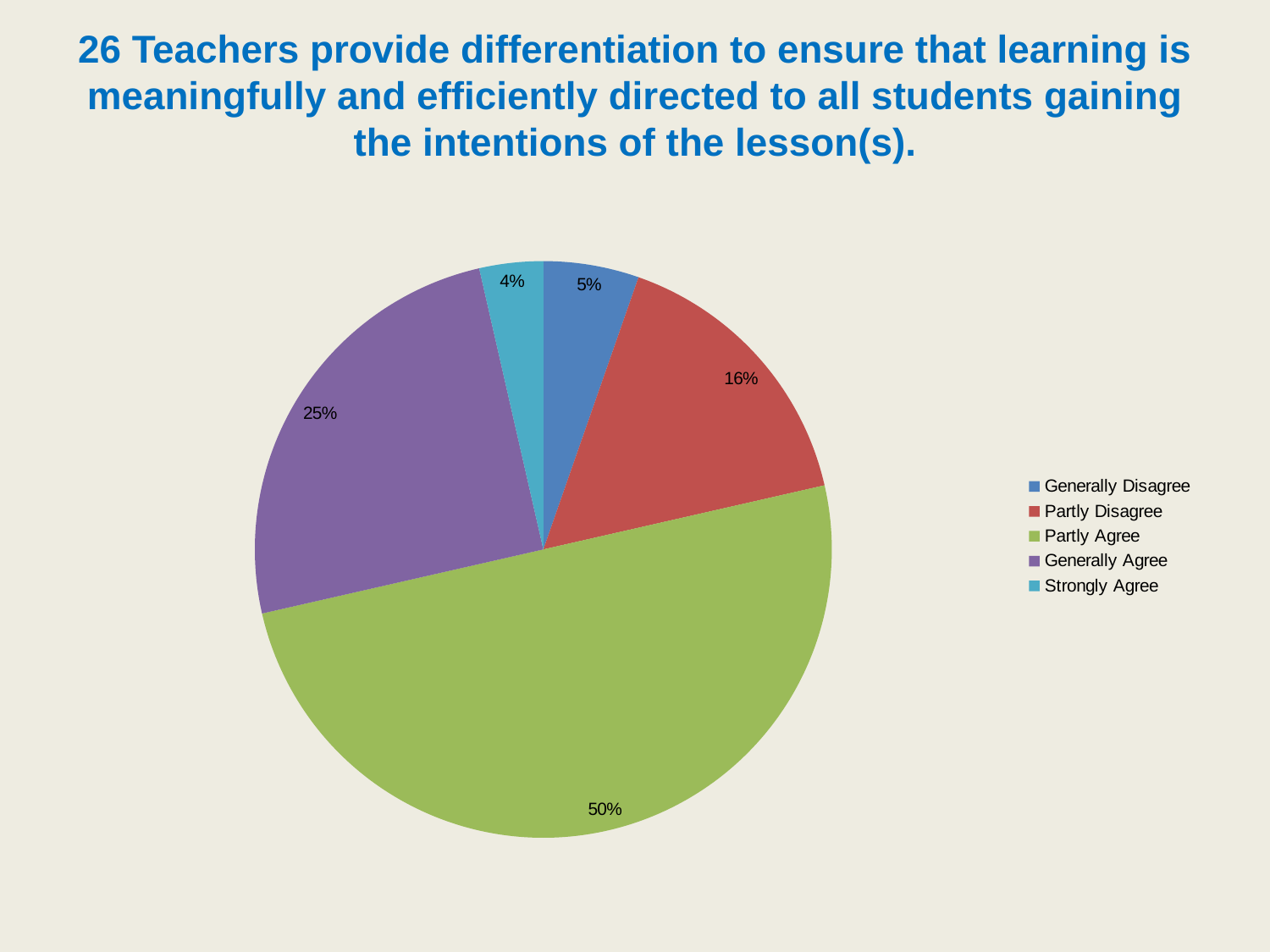
What percentage is shown for Generally Disagree? 5% What share of the pie does Partly Agree represent? 50% What type of chart is shown on the slide? Pie chart What percentage is shown for Generally Agree? 25% Which category has the smallest slice of the pie? Strongly Agree How many categories does the pie chart show? 5 Which is larger, Partly Disagree or Generally Agree? Generally Agree What percentage is shown for Partly Disagree? 16% What colour is the Partly Agree slice? Green Which category has the largest slice of the pie? Partly Agree What percentage is shown for Strongly Agree? 4% What is the difference in percentage points between Partly Agree and Generally Agree? 25